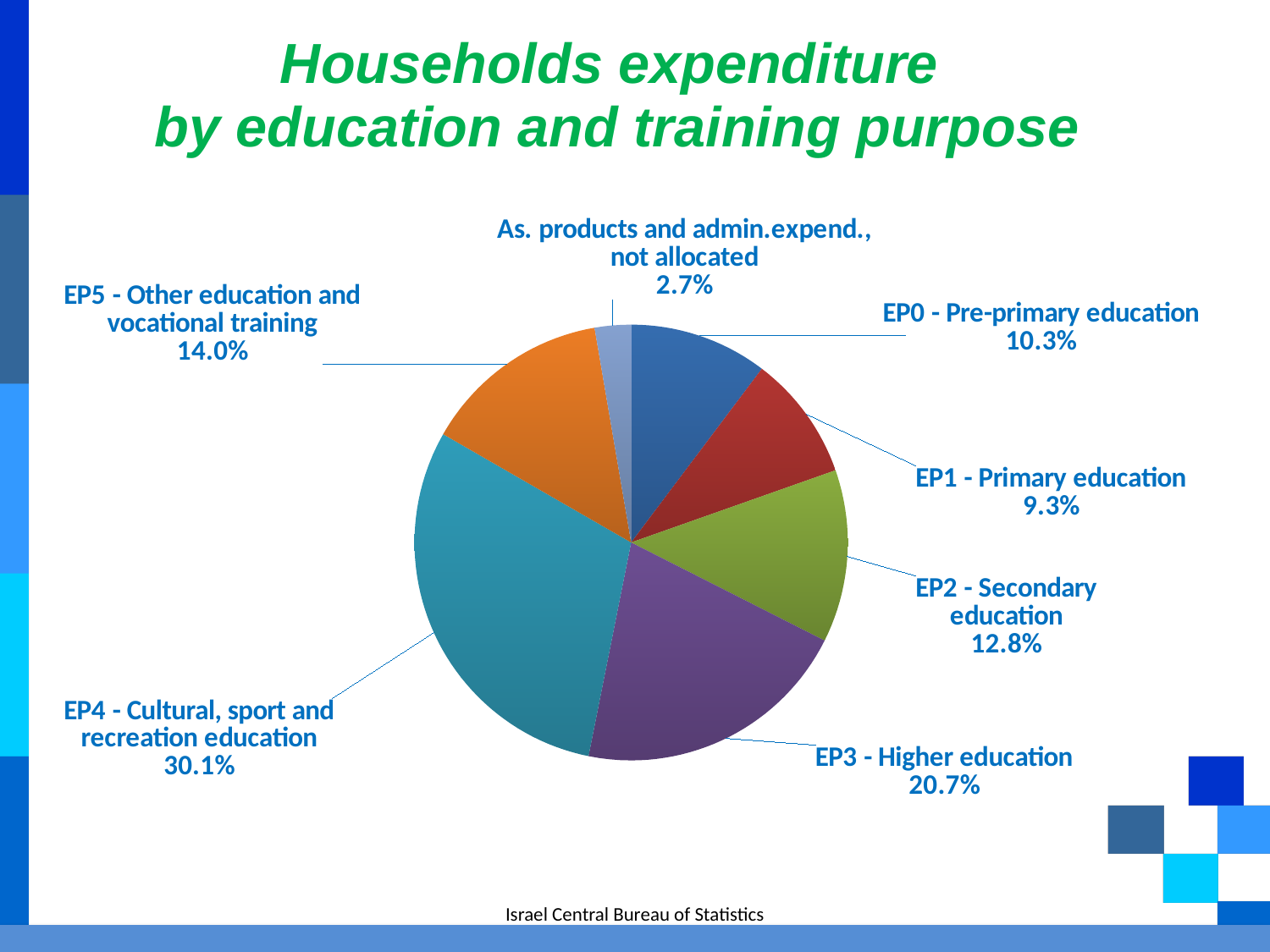
What is the difference between the shares of EP4 - Cultural, sport and recreation education and EP3 - Higher education? 9.4% What kind of chart is shown on the slide? pie chart What share of households expenditure goes to EP3 - Higher education? 20.7% What is the value for EP0 - Pre-primary education? 10.3% Which category has the largest share of the pie? EP4 - Cultural, sport and recreation education What is the value for EP2 - Secondary education? 12.8% What is the title of the chart? Households expenditure by education and training purpose What is the value for the slice labelled 'As. products and admin.expend., not allocated'? 2.7% How many slices does the pie chart have? 7 What is the difference between the shares of EP0 - Pre-primary education and EP1 - Primary education? 1.0% Which is larger, the share for EP5 - Other education and vocational training or for EP2 - Secondary education? EP5 - Other education and vocational training Which category has the smallest share of the pie? As. products and admin.expend., not allocated